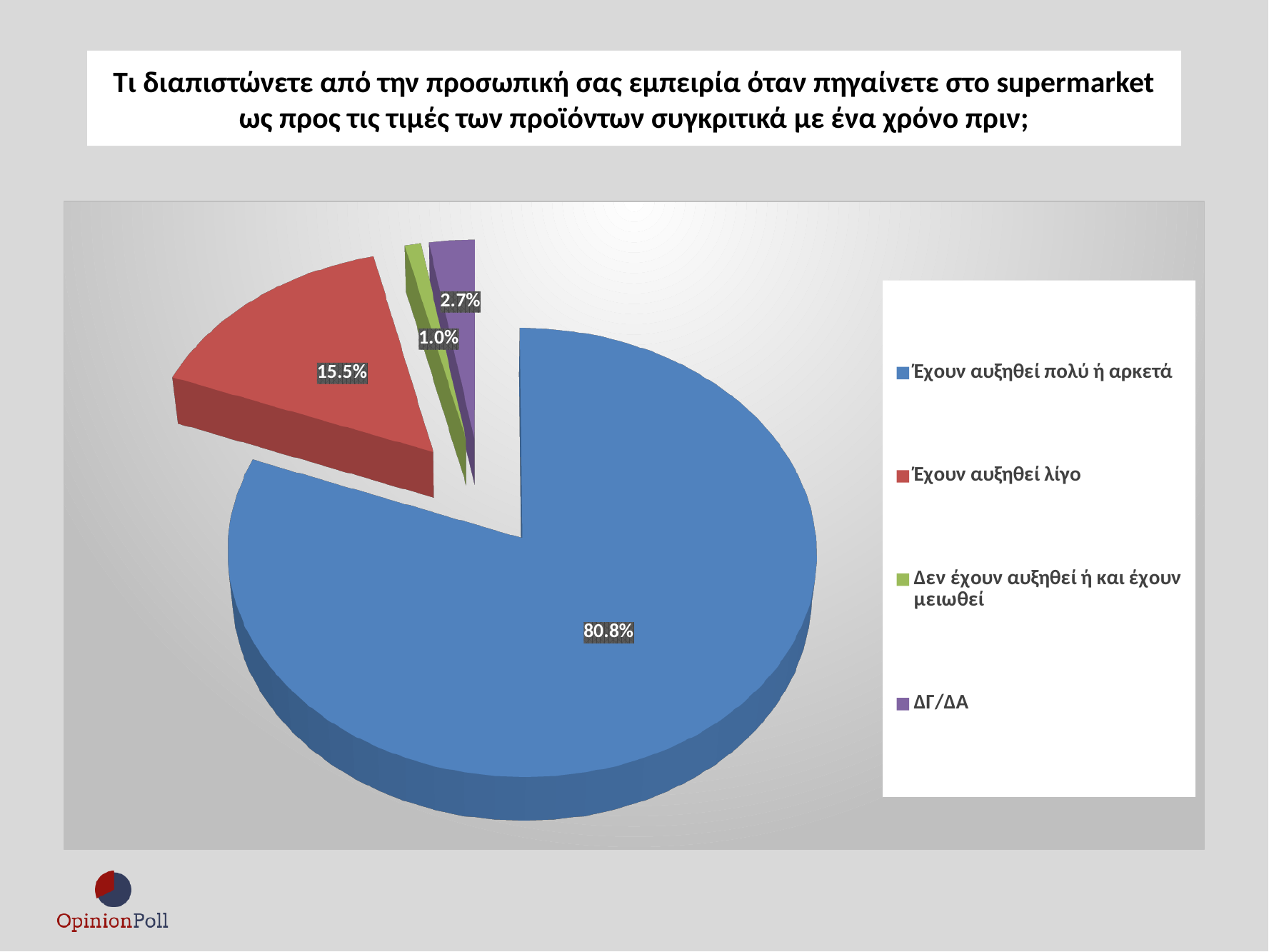
Which response category has the smallest share of the pie? Δεν έχουν αυξηθεί ή και έχουν μειωθεί What percentage of respondents answered 'Έχουν αυξηθεί λίγο'? 15.5% What colour is the slice representing 'Έχουν αυξηθεί λίγο'? Red How many categories are shown in the pie chart? 4 What percentage of respondents answered 'Δεν έχουν αυξηθεί ή και έχουν μειωθεί'? 1.0% What percentage of respondents answered 'ΔΓ/ΔΑ'? 2.7% What type of chart is shown on the slide? Pie chart What is the difference in percentage points between 'Έχουν αυξηθεί πολύ ή αρκετά' and 'Έχουν αυξηθεί λίγο'? 65.3 Which is larger: the share for 'ΔΓ/ΔΑ' or the share for 'Δεν έχουν αυξηθεί ή και έχουν μειωθεί'? ΔΓ/ΔΑ What is the combined share of 'Έχουν αυξηθεί πολύ ή αρκετά' and 'Έχουν αυξηθεί λίγο'? 96.3% What percentage of respondents answered 'Έχουν αυξηθεί πολύ ή αρκετά'? 80.8% Which response category has the largest share of the pie? Έχουν αυξηθεί πολύ ή αρκετά